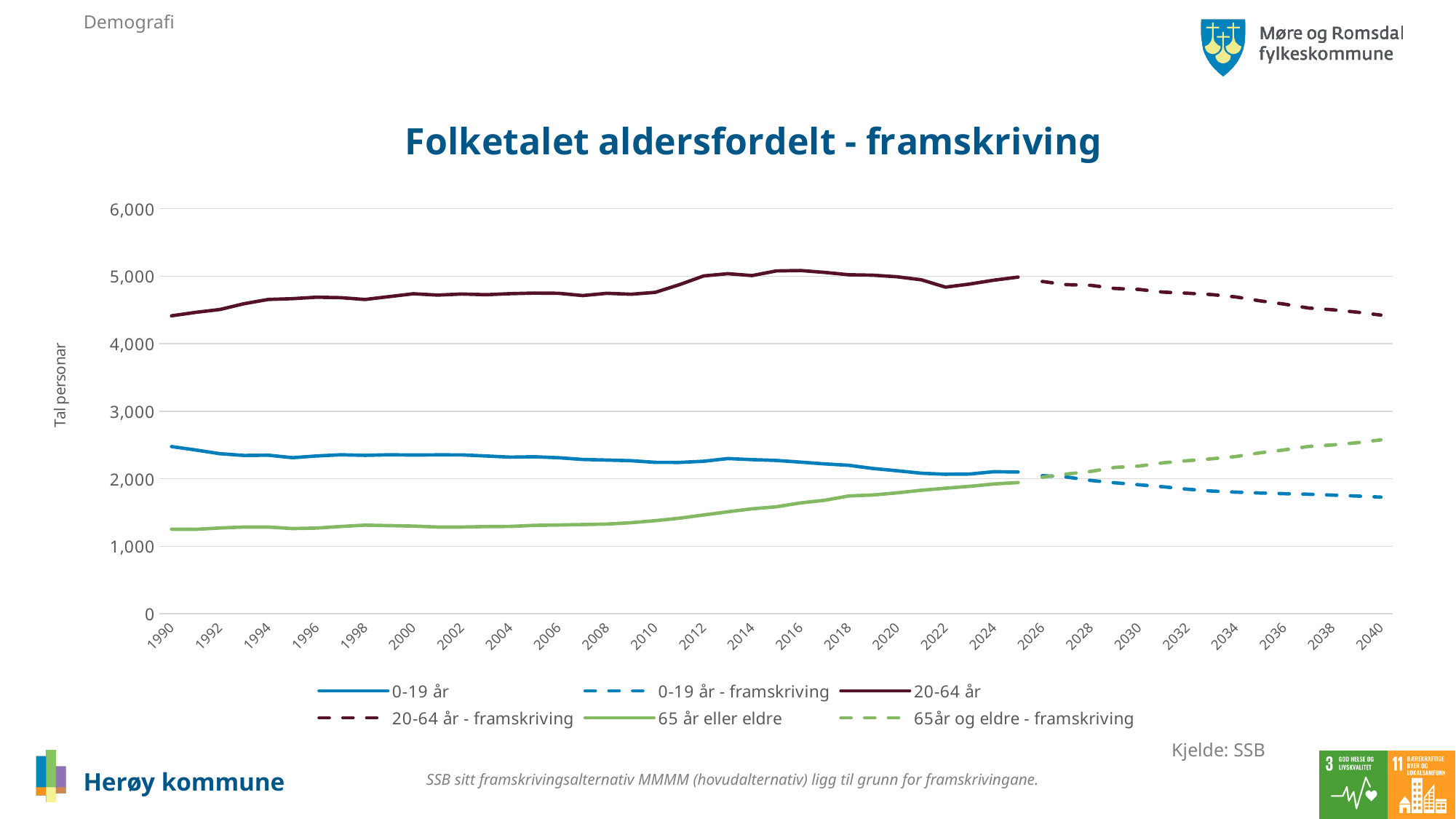
What kind of chart is shown on the slide? line chart Is the value for 0-19 år in 1990 greater or less than 2,000? greater Is the value for 65 år eller eldre in 1990 greater or less than 2,000? less How many series does the legend list? 6 What is the title of the chart? Folketalet aldersfordelt - framskriving Is the value for 65år og eldre - framskriving in 2040 greater or less than 2,000? greater Does the 65 år eller eldre line rise or fall from 1990 to 2024? rise What source is cited below the chart? Kjelde: SSB In 2040, which is higher: 65år og eldre - framskriving or 0-19 år - framskriving? 65år og eldre - framskriving Which series has the highest values across the whole chart? 20-64 år